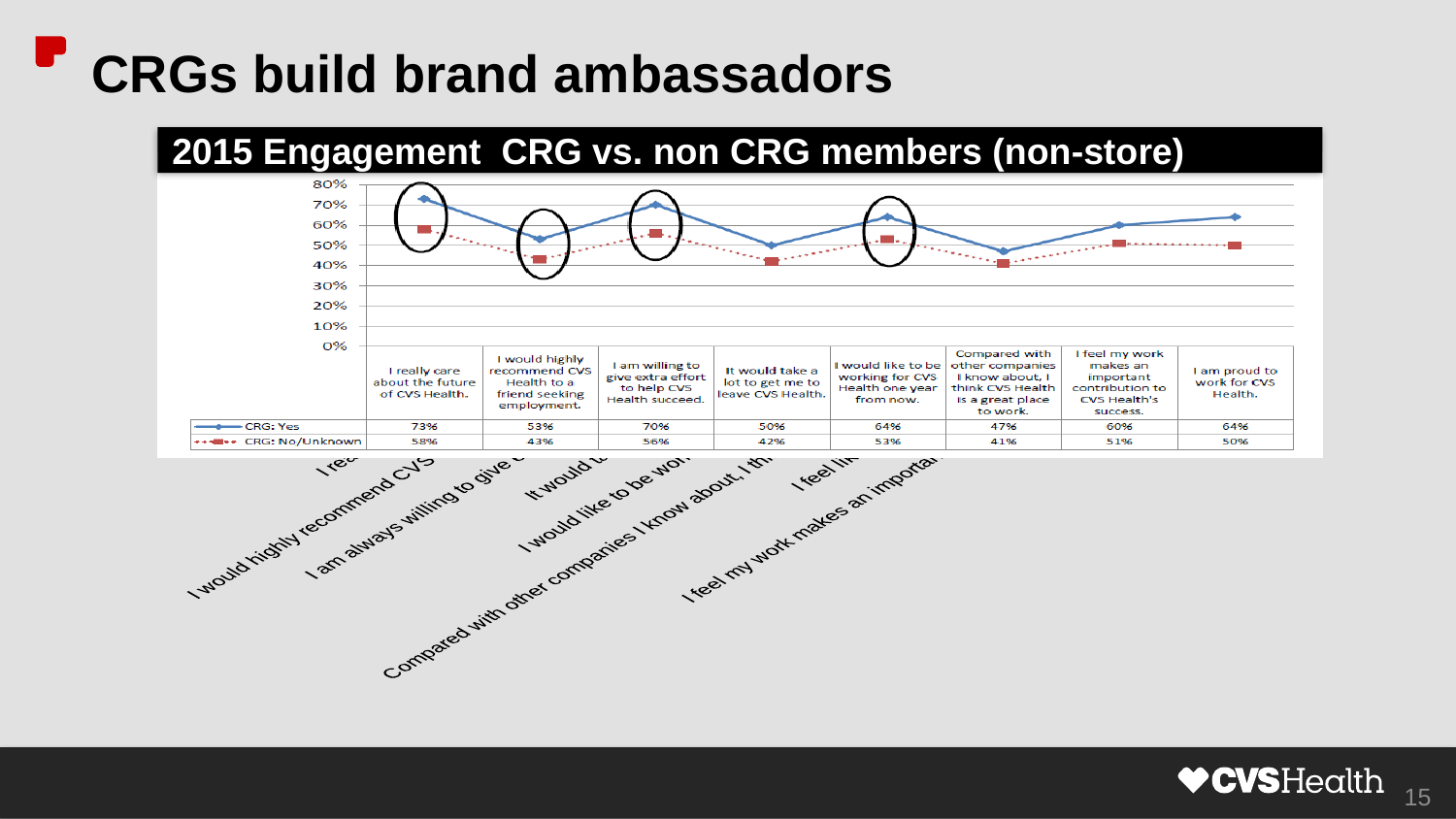
What type of chart is shown on the slide? Line chart Is the CRG: Yes value for "It would take a lot to get me to leave CVS Health." greater or less than 40%? greater What is the value for CRG: Yes for "I am proud to work for CVS Health."? 64% What is the title of the chart? 2015 Engagement CRG vs. non CRG members (non-store) What is the difference between CRG: Yes and CRG: No/Unknown for "I am willing to give extra effort to help CVS Health succeed."? 14% Which category has the highest value for the CRG: Yes series? I really care about the future of CVS Health. Which series has the larger value for "I feel my work makes an important contribution to CVS Health's success."? CRG: Yes What is the value for CRG: Yes for "I really care about the future of CVS Health."? 73% What is the value for CRG: No/Unknown for "I would highly recommend CVS Health to a friend seeking employment."? 43% How many categories (survey statements) are plotted along the x axis? 8 Which category has the lowest value for the CRG: No/Unknown series? Compared with other companies I know about, I think CVS Health is a great place to work. How many series does the legend list? 2